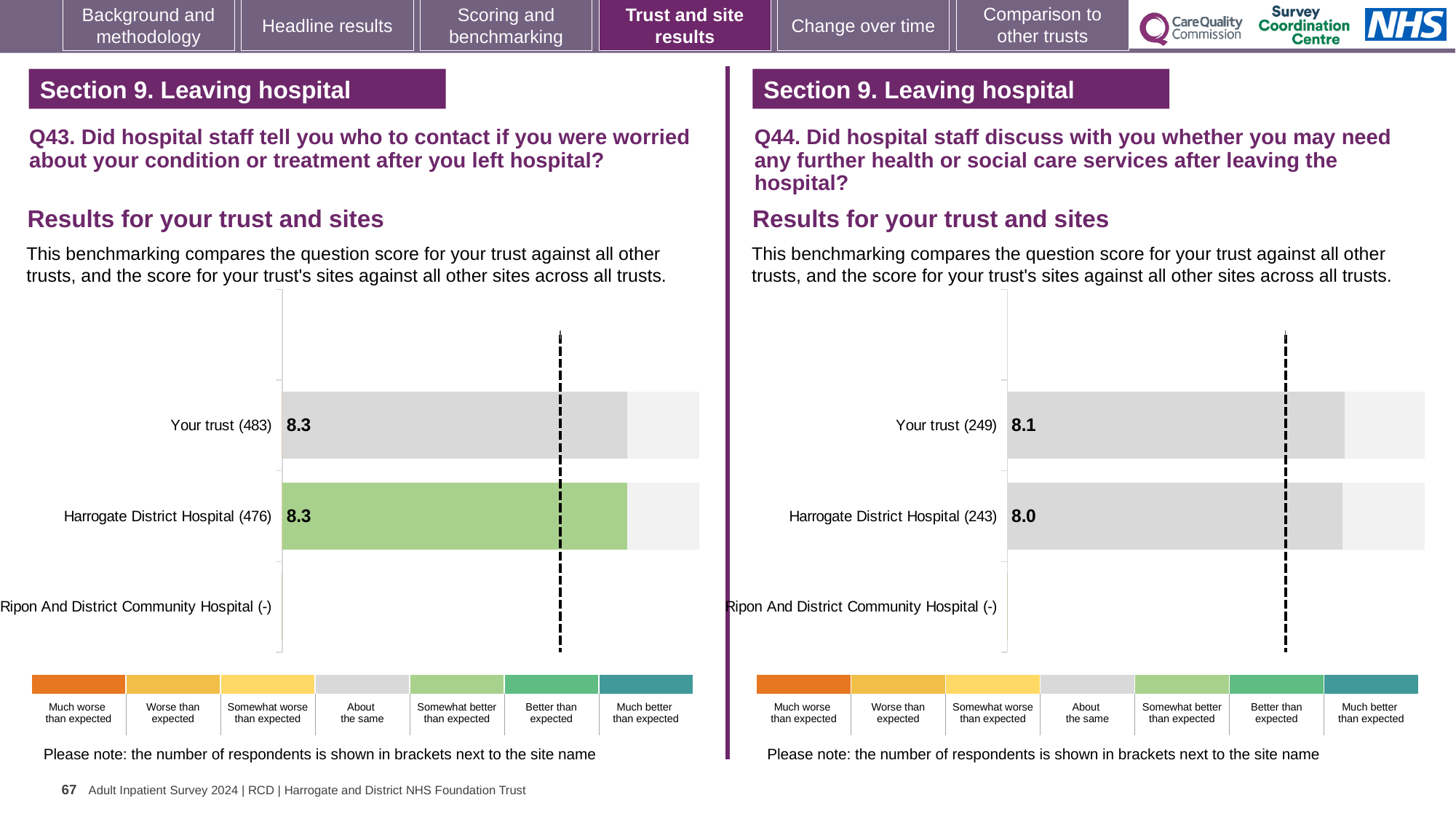
What kind of chart is used in the Q43 chart on the left? Bar chart In the Q43 chart on the left, which benchmark category does the green colour of the Harrogate District Hospital bar represent? Somewhat better than expected In the Q44 chart on the right, which benchmark category does the grey colour of the Your trust bar represent? About the same In the Q44 chart on the right, what is the score for Your trust? 8.1 In the Q43 chart on the left, how many site/trust categories are listed on the vertical axis? 3 In the Q44 chart on the right, what is the difference between the score for Your trust and the score for Harrogate District Hospital? 0.1 In the Q44 chart on the right, which has the higher score, Your trust or Harrogate District Hospital? Your trust In the Q43 chart on the left, what is the score for Harrogate District Hospital? 8.3 In the Q44 chart on the right, what is the score for Harrogate District Hospital? 8.0 In the Q43 chart on the left, how many respondents are shown in brackets for Your trust? 483 In the Q43 chart on the left, what is the score for Your trust? 8.3 In the Q44 chart on the right, how many respondents are shown in brackets for Harrogate District Hospital? 243